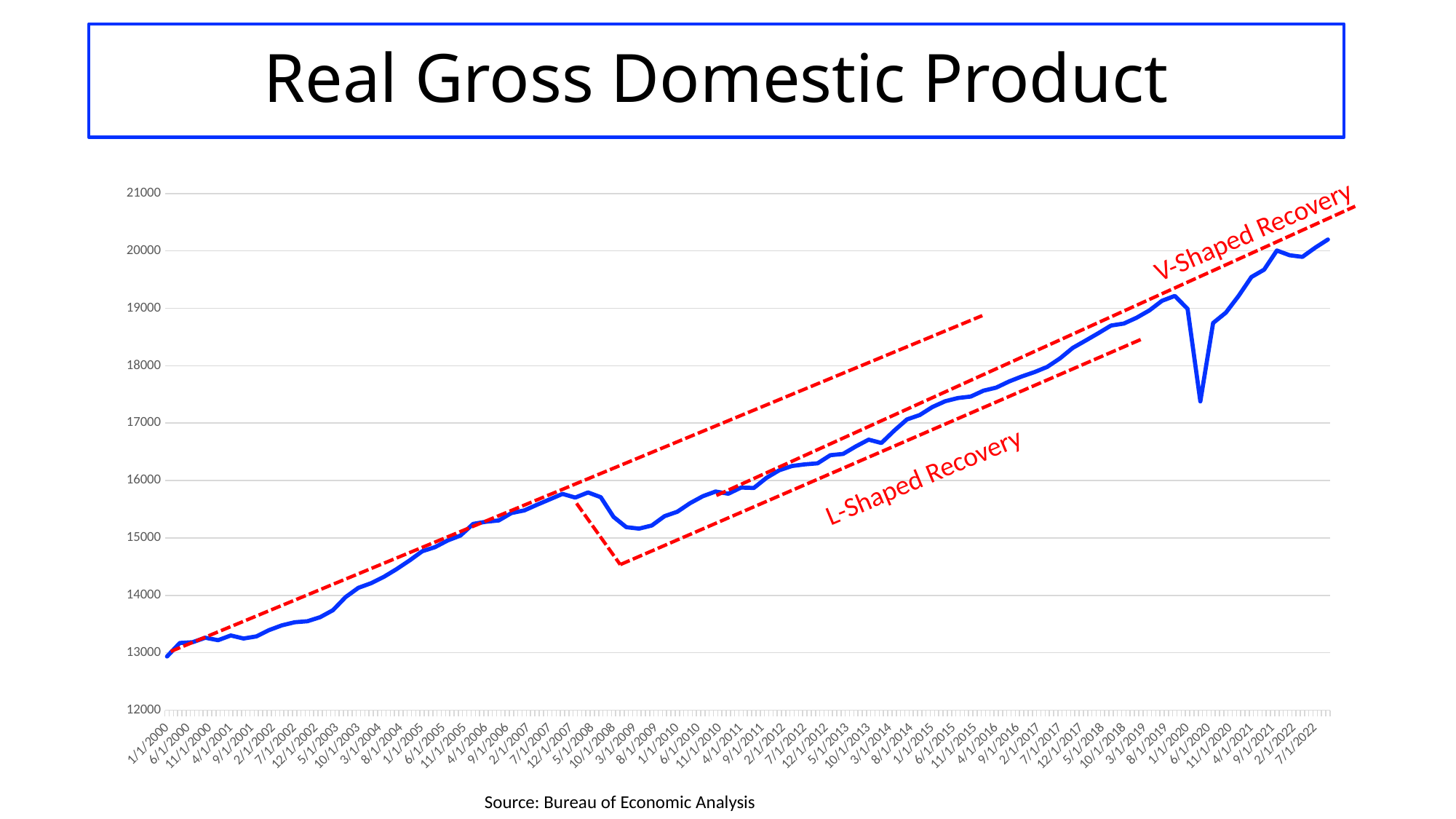
Is the lowest value on the line at the start or the end of the period? Start Which is larger, the value at 12/1/2007 or the value at 3/1/2009? 12/1/2007 What is the title of the chart? Real Gross Domestic Product Is the value at the 6/1/2020 dip greater or less than 18000? less Is the value at 1/1/2000 greater or less than 14000? less What source is cited below the chart? Bureau of Economic Analysis Is the value at 3/1/2009 greater or less than 16000? less Overall, do the values rise or fall from 1/1/2000 to 7/1/2022? Rise What kind of chart is shown on the slide? Line chart Which is larger, the value at 8/1/2019 or the value at 6/1/2020? 8/1/2019